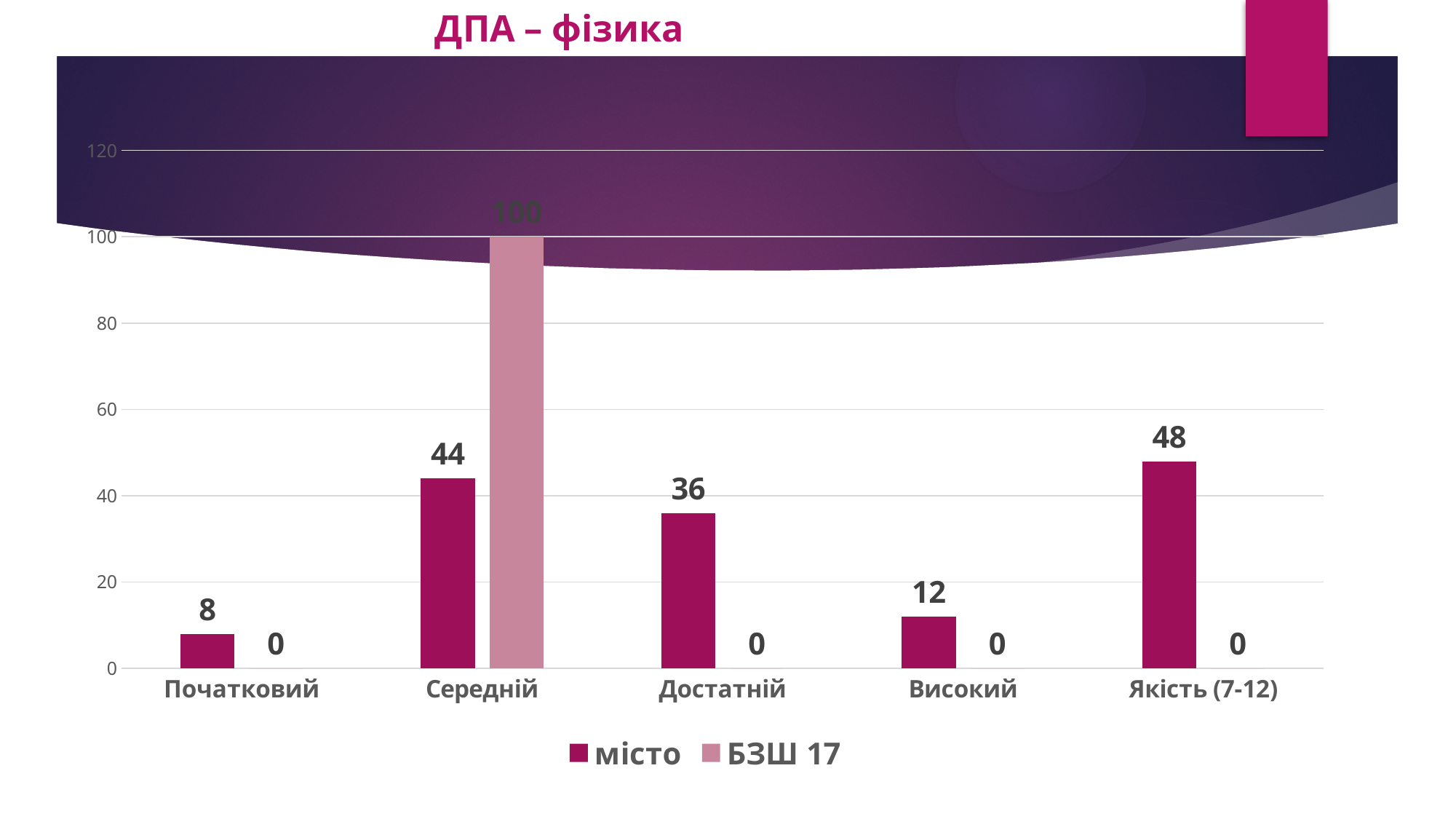
How many series does the legend list? 2 What is the value for місто in the Високий category? 12 How many categories are shown on the x axis? 5 What is the value for місто in the Середній category? 44 Which is larger in the Середній category: місто or БЗШ 17? БЗШ 17 What is the value for місто in the Якість (7-12) category? 48 Which category has the lowest value for the місто series? Початковий What is the title of the slide? ДПА – фізика What is the value for БЗШ 17 in the Середній category? 100 What is the difference between the місто values for Середній and Достатній? 8 What kind of chart is shown on the slide? Bar chart Which category has the highest value for the місто series? Якість (7-12)